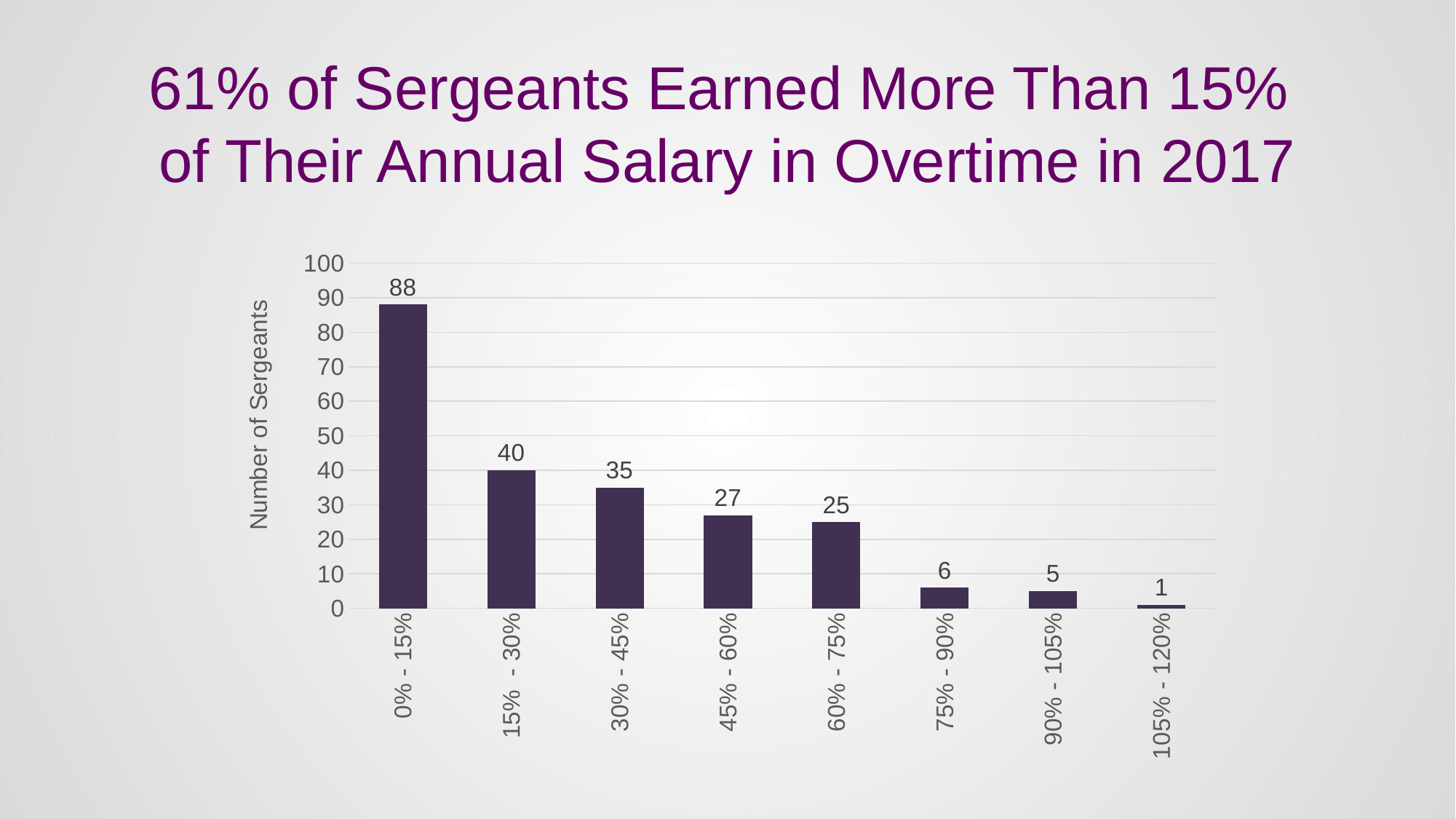
Which category has the highest number of sergeants? 0% - 15% What is the difference between the 0% - 15% and 60% - 75% categories? 63 How many categories are shown on the x axis? 8 What is the value for the 90% - 105% category? 5 Which category has the lowest number of sergeants? 105% - 120% What kind of chart is shown on the slide? bar chart What is the value for the 45% - 60% category? 27 Is the value for 15% - 30% greater or less than 50? less What is the label of the vertical axis? Number of Sergeants Which is larger, the value for 60% - 75% or the value for 75% - 90%? 60% - 75% What is the difference between the 15% - 30% and 30% - 45% categories? 5 How many sergeants are in the 0% - 15% category? 88